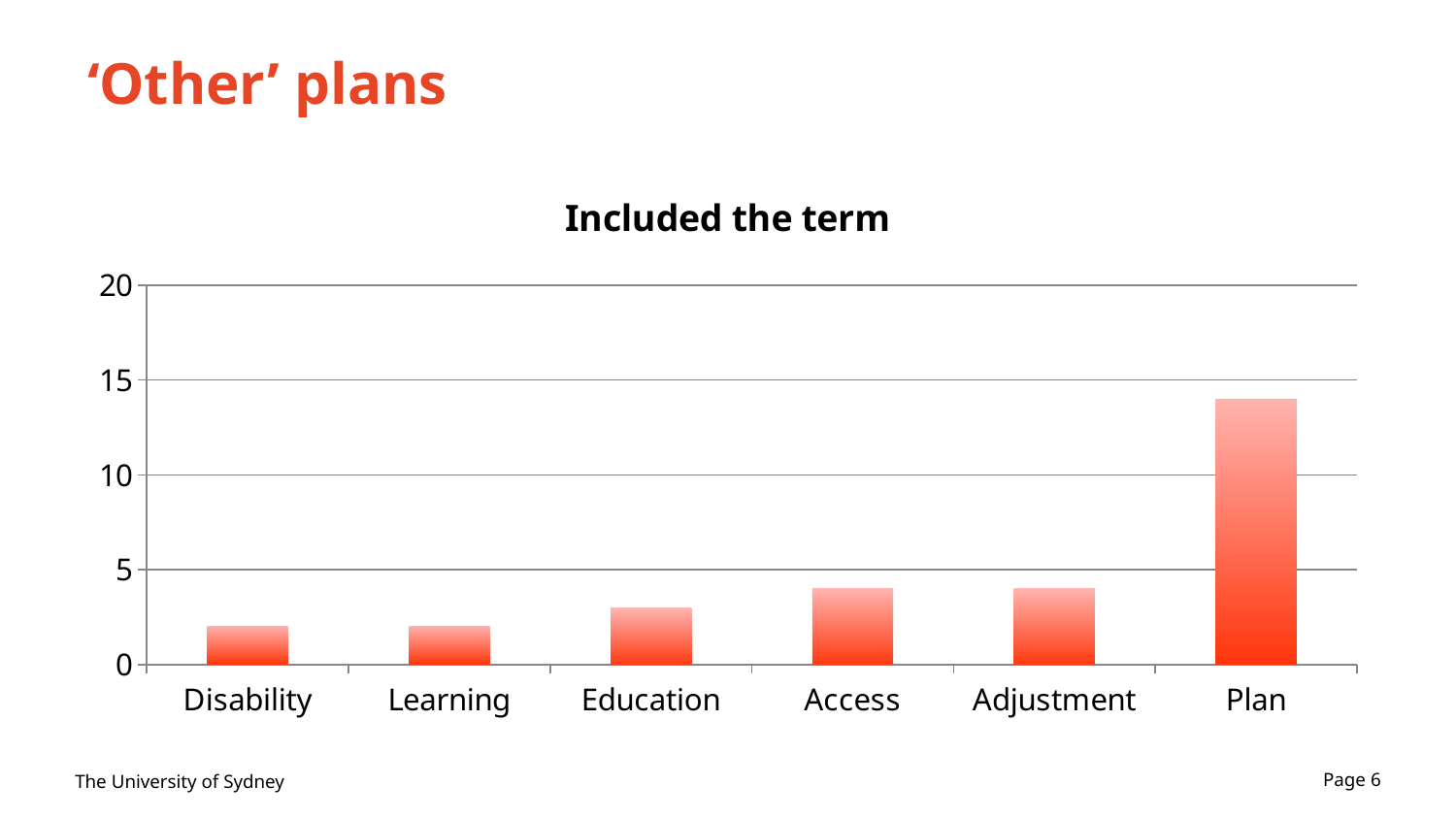
What kind of chart is shown on the slide? bar chart Which category has the highest value in the chart? Plan What is the label of the rightmost category on the x axis? Plan Is the value for Access greater or less than 5? less Is the value for Disability greater or less than 5? less Do the values generally rise or fall from left to right across the categories? rise How many categories are shown on the x axis of the chart? 6 Is the value for Plan greater or less than 15? less Which has the larger value, Education or Learning? Education Which has the larger value, Plan or Adjustment? Plan What is the title of the chart? Included the term